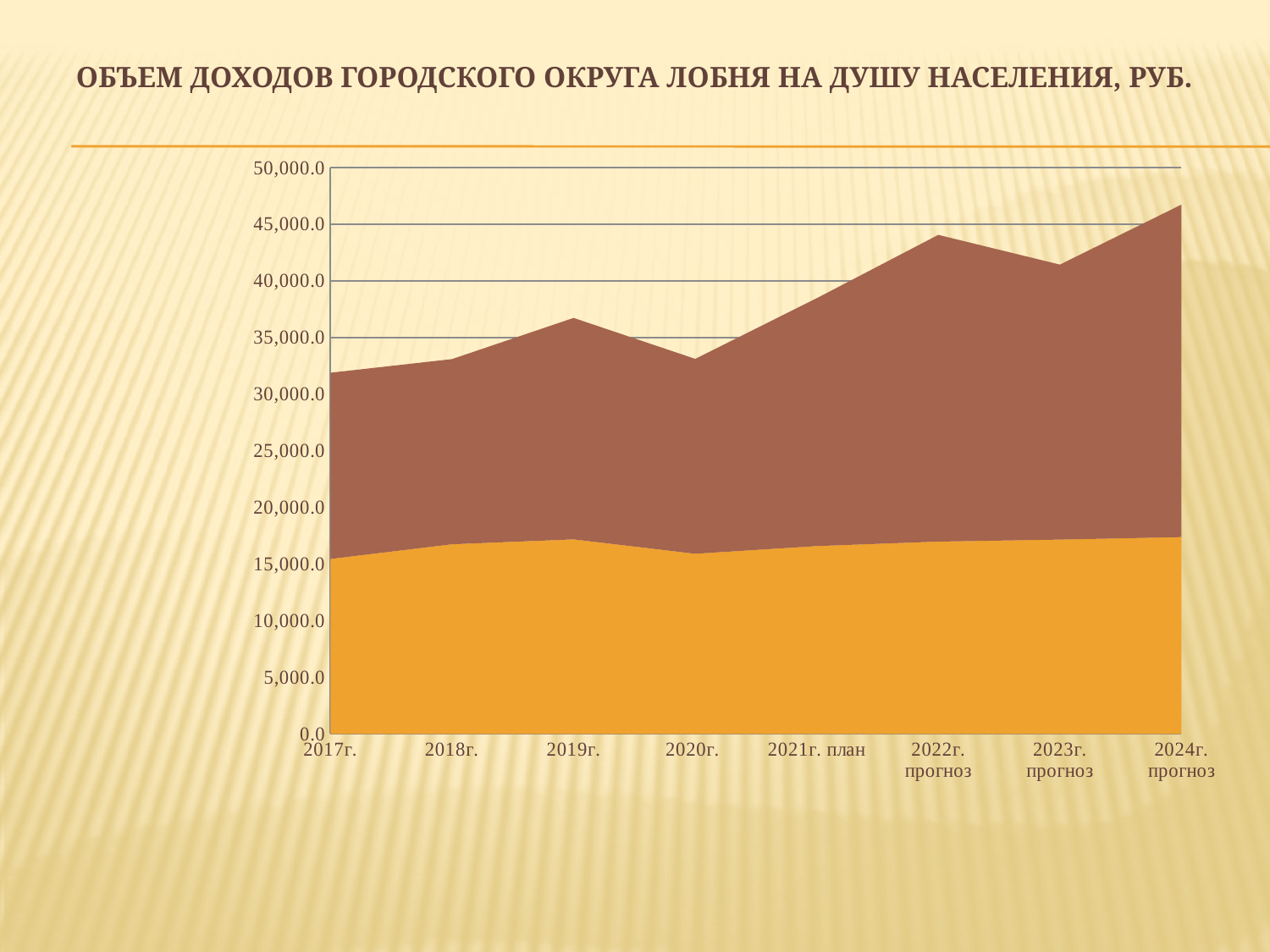
Which has the larger total value, 2022г. прогноз or 2023г. прогноз? 2022г. прогноз Is the total value for 2024г. прогноз greater or less than 45,000.0? greater Is the total value for 2017г. greater or less than 30,000.0? greater What kind of chart is shown on the slide? area chart Is the value of the bottom (orange) series for 2024г. прогноз greater or less than 20,000.0? less Which has the larger total value, 2019г. or 2020г.? 2019г. Do the total values generally rise or fall from 2017г. to 2024г. прогноз? rise What is the title of the chart? ОБЪЕМ ДОХОДОВ ГОРОДСКОГО ОКРУГА ЛОБНЯ НА ДУШУ НАСЕЛЕНИЯ, РУБ. How many categories are shown along the x axis? 8 Which category has the highest total value? 2024г. прогноз